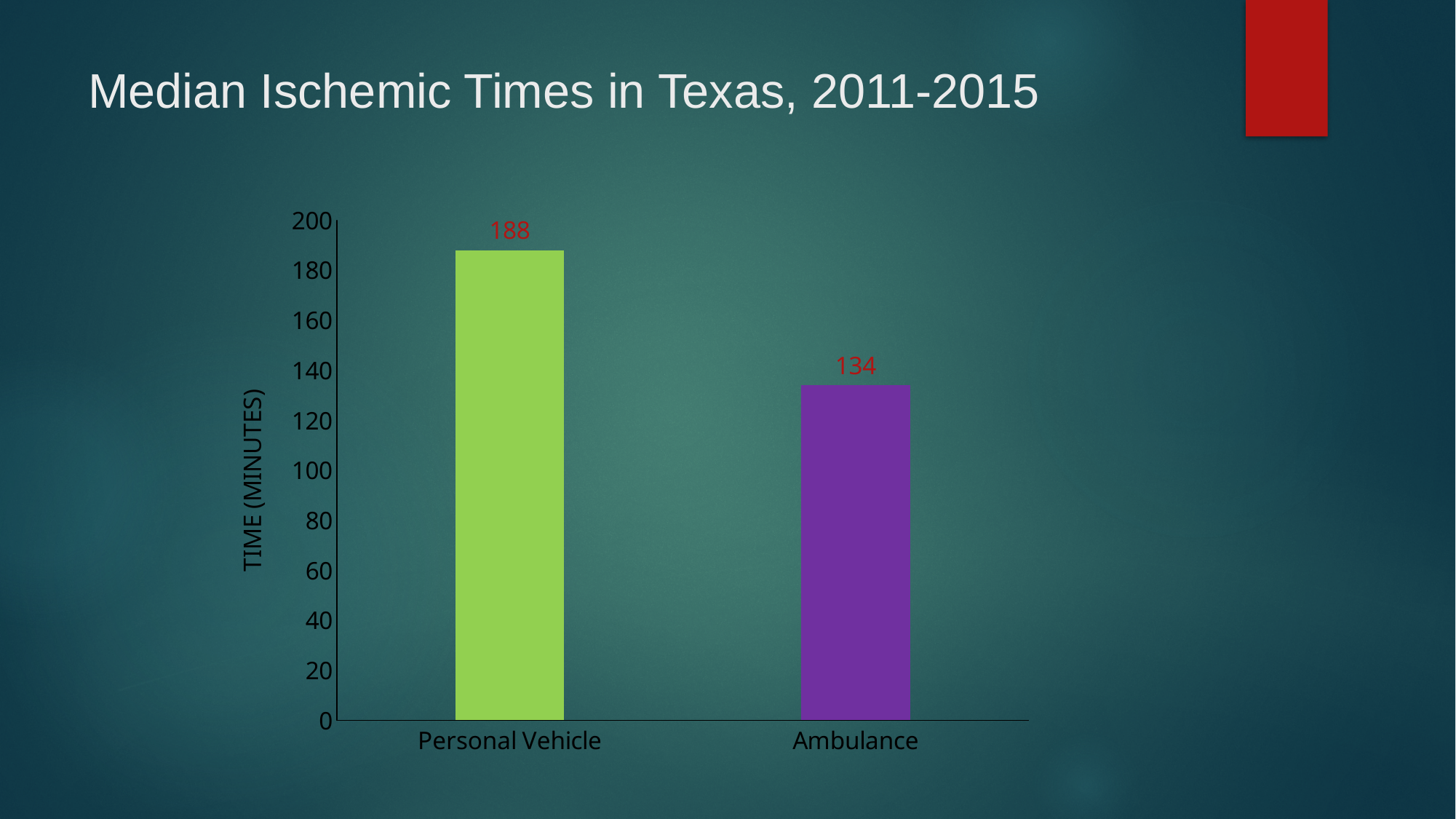
Is the value for Personal Vehicle greater or less than 180? greater Which category has the highest median ischemic time? Personal Vehicle Which category has the lowest median ischemic time? Ambulance How many categories are shown on the chart? 2 What is the difference between the Personal Vehicle and Ambulance values? 54 What is the median ischemic time for Ambulance? 134 Is the value for Ambulance greater or less than 140? less What is the median ischemic time for Personal Vehicle? 188 Which is larger, the value for Personal Vehicle or the value for Ambulance? Personal Vehicle What is the title of the slide? Median Ischemic Times in Texas, 2011-2015 What is the label of the vertical axis? TIME (MINUTES) What kind of chart is shown on the slide? Bar chart